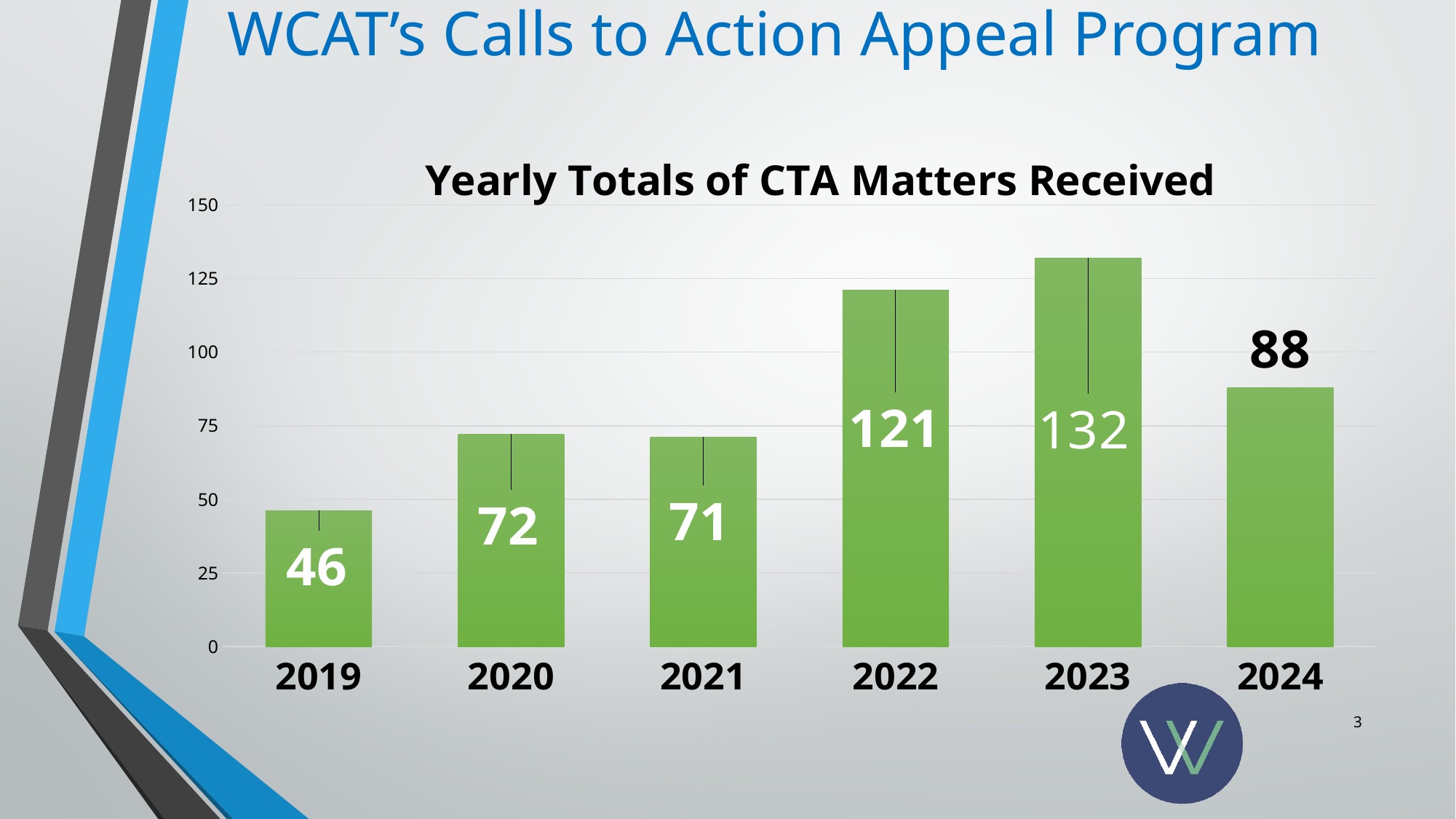
What is the difference between the values for 2023 and 2022? 11 What is the value for 2023? 132 Is the value for 2022 greater or less than 100? greater Which year has the lowest value? 2019 What is the title of the chart? Yearly Totals of CTA Matters Received How many years are shown on the chart? 6 What is the difference between the values for 2024 and 2019? 42 What is the value for 2024? 88 Which year has the highest value? 2023 What kind of chart is shown? bar chart What is the value for 2019? 46 Which is larger, the value for 2022 or the value for 2024? 2022